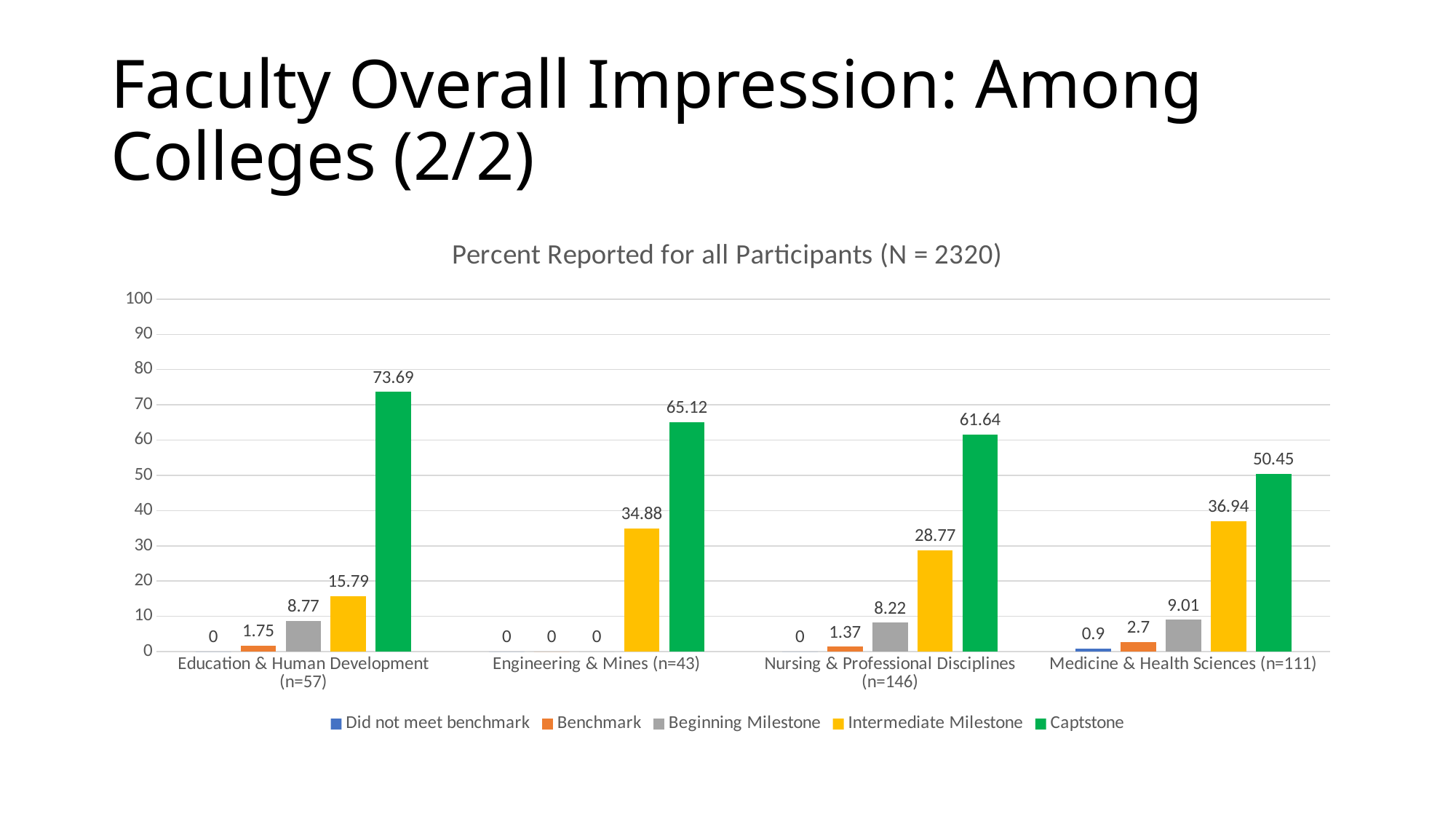
What is the title of the chart? Percent Reported for all Participants (N = 2320) What kind of chart is shown on the slide? bar chart How many colleges are shown on the x axis? 4 Which is larger: the Intermediate Milestone value for Engineering & Mines (n=43) or for Nursing & Professional Disciplines (n=146)? Engineering & Mines (n=43) Which college has the lowest Captstone value? Medicine & Health Sciences (n=111) Is the Captstone value for Nursing & Professional Disciplines (n=146) greater or less than 60? greater What is the difference between the Captstone values for Education & Human Development (n=57) and Medicine & Health Sciences (n=111)? 23.24 What is the Benchmark value for Nursing & Professional Disciplines (n=146)? 1.37 How many series does the legend list? 5 What is the Captstone value for Engineering & Mines (n=43)? 65.12 What is the Intermediate Milestone value for Medicine & Health Sciences (n=111)? 36.94 Which college has the highest Captstone value? Education & Human Development (n=57)